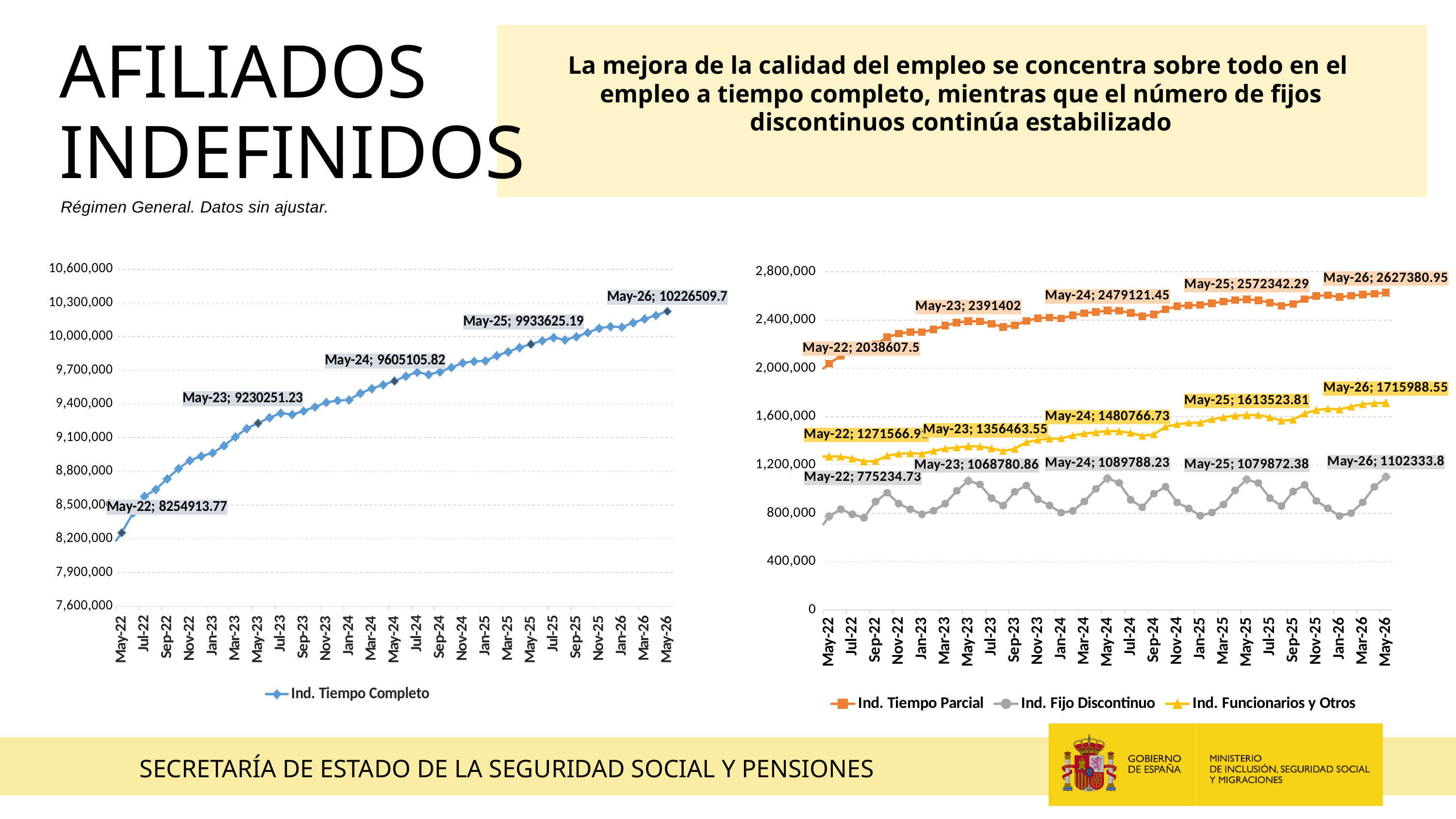
On the left chart, what is the value of Ind. Tiempo Completo for May-26? 10226509.7 On the left chart, do the values of Ind. Tiempo Completo rise or fall from May-22 to May-26? rise On the right chart, what is the value of Ind. Tiempo Parcial for May-24? 2479121.45 On the right chart, what is the value of Ind. Funcionarios y Otros for May-25? 1613523.81 On the right chart, which series has the highest value at May-26? Ind. Tiempo Parcial On the left chart, what is the value of Ind. Tiempo Completo for May-22? 8254913.77 On the right chart, what is the value of Ind. Fijo Discontinuo for May-26? 1102333.8 On the right chart, what is the difference between the May-26 and May-25 values of Ind. Tiempo Parcial? 55038.66 On the left chart, what is the difference between the May-26 and May-22 values of Ind. Tiempo Completo? 1971595.93 How many series does the legend of the right chart list? 3 On the left chart, is the value of Ind. Tiempo Completo for Jan-23 greater or less than 8,800,000? greater On the right chart, which series has the lowest value at May-26? Ind. Fijo Discontinuo